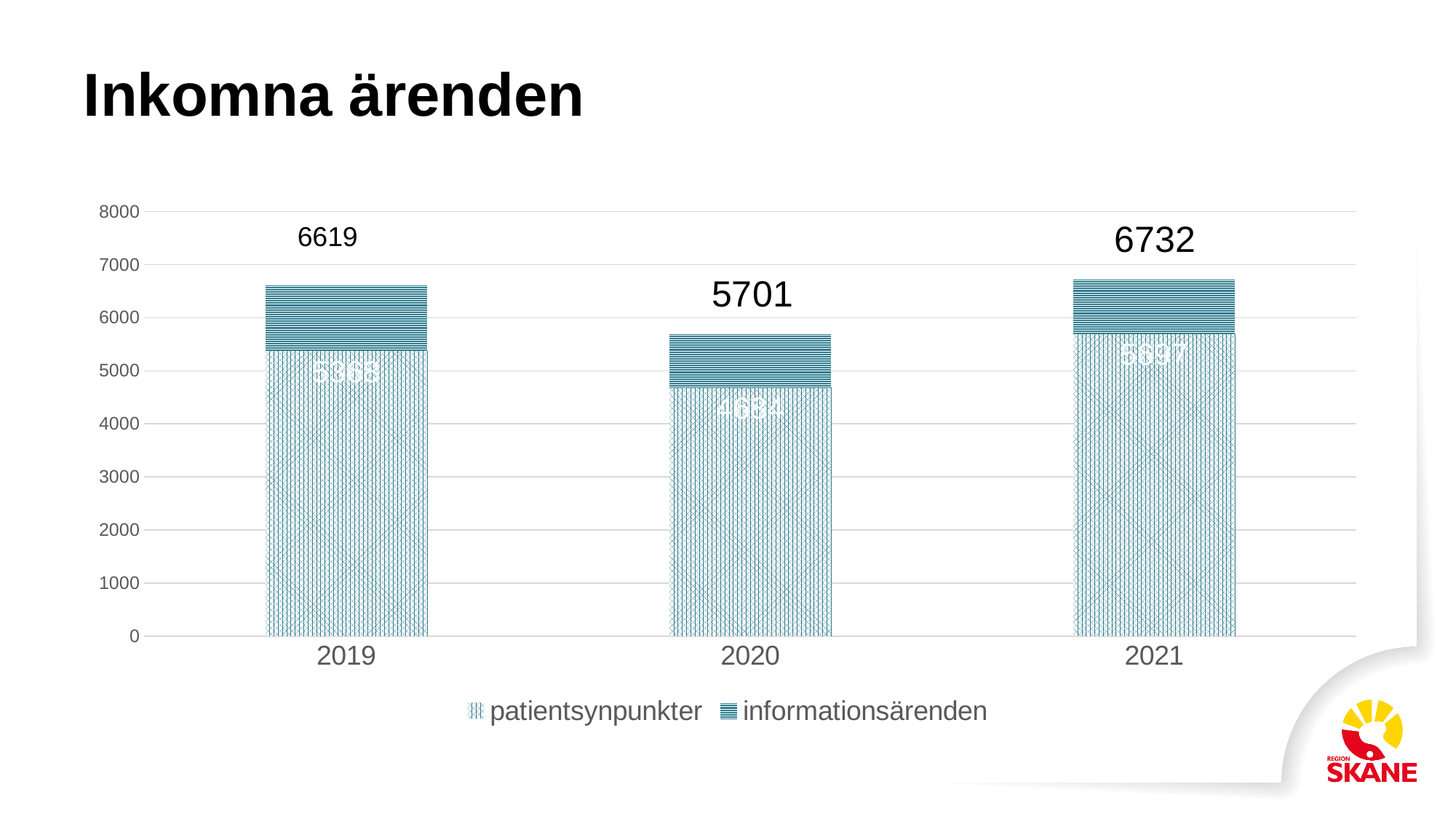
What is the difference between the total for 2019 and the total for 2020? 918 What is the total number of incoming cases shown for 2020? 5701 What kind of chart is shown on the slide? bar chart Is the value for patientsynpunkter in 2020 greater or less than 5000? less How many years are shown on the x axis of the chart? 3 How many series does the legend list? 2 What are the two series named in the legend? patientsynpunkter and informationsärenden What is the total number of incoming cases (inkomna ärenden) shown for 2019? 6619 Which year has the lowest total of incoming cases? 2020 What is the total number of incoming cases shown for 2021? 6732 Which year has the highest total of incoming cases? 2021 What is the difference between the total for 2021 and the total for 2019? 113